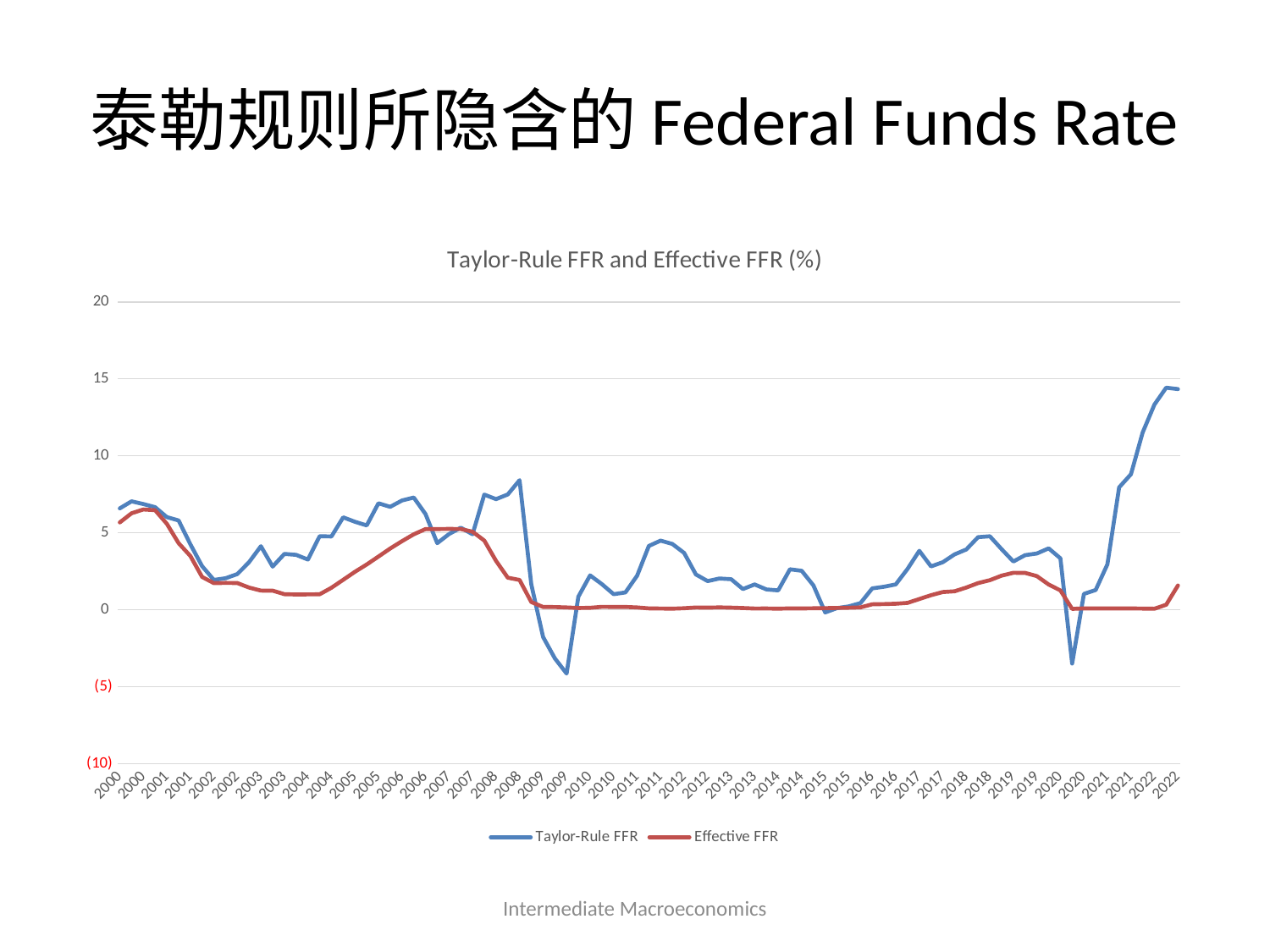
Is the value of Effective FFR in 2012 greater or less than 5? less Which series reaches the highest value anywhere on the chart? Taylor-Rule FFR At the end of 2022, which series is higher, Taylor-Rule FFR or Effective FFR? Taylor-Rule FFR What kind of chart is shown on the slide? Line chart How many series does the legend list? 2 Is the value of Taylor-Rule FFR at the end of 2022 greater or less than 10? greater Which series reaches the lowest value anywhere on the chart? Taylor-Rule FFR What is the title of the chart? Taylor-Rule FFR and Effective FFR (%) Is the value of Effective FFR at the end of 2022 greater or less than 5? less Which series is drawn in blue? Taylor-Rule FFR Does the Taylor-Rule FFR rise or fall from 2020 to 2022? rise